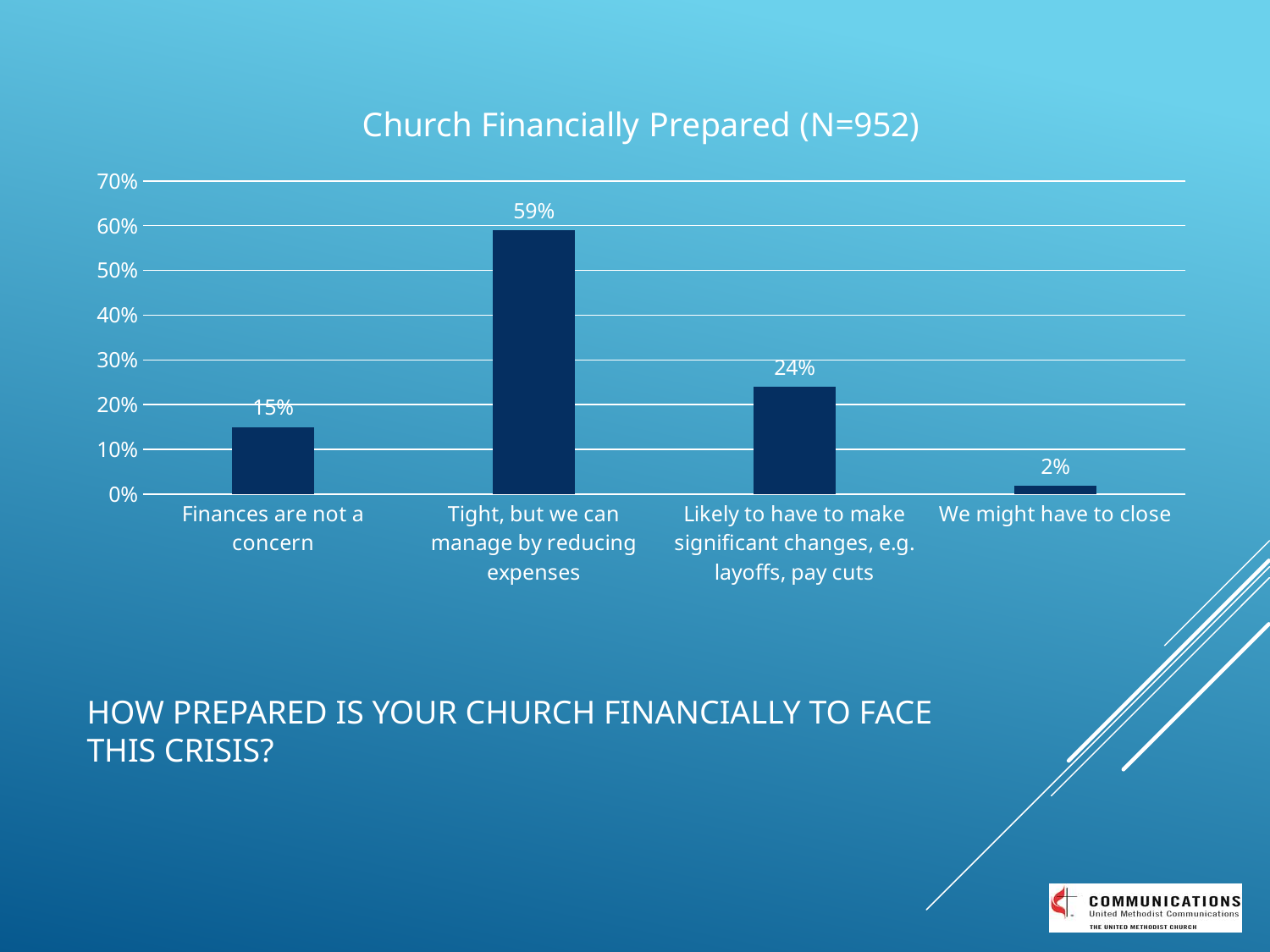
What is the value for "We might have to close"? 2% What kind of chart is shown on the slide? Bar chart Which category has the lowest value? We might have to close What is the value for "Likely to have to make significant changes, e.g. layoffs, pay cuts"? 24% What is the title of the chart? Church Financially Prepared (N=952) What is the difference between the values for "Likely to have to make significant changes, e.g. layoffs, pay cuts" and "Finances are not a concern"? 9% Which is larger: the value for "Finances are not a concern" or the value for "Likely to have to make significant changes, e.g. layoffs, pay cuts"? Likely to have to make significant changes, e.g. layoffs, pay cuts Which category has the highest value? Tight, but we can manage by reducing expenses How many categories are shown in the chart? 4 What is the value for "Finances are not a concern"? 15% What is the value for "Tight, but we can manage by reducing expenses"? 59% What is the difference between the values for "Tight, but we can manage by reducing expenses" and "Likely to have to make significant changes, e.g. layoffs, pay cuts"? 35%